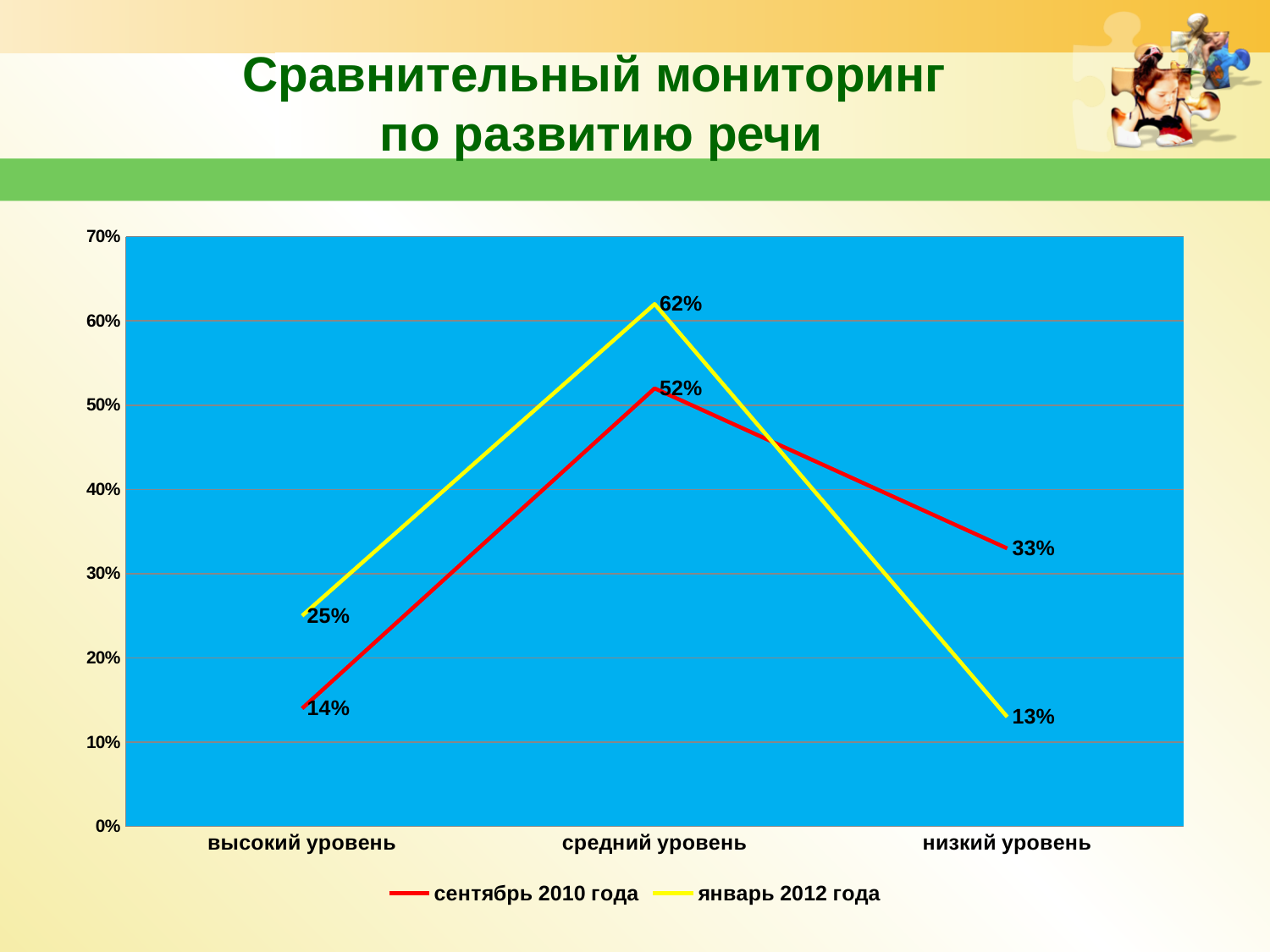
Which series has the larger value for низкий уровень, сентябрь 2010 года or январь 2012 года? сентябрь 2010 года How many categories are shown on the x axis? 3 What is the value for высокий уровень in the январь 2012 года series? 25% What colour is the line for the январь 2012 года series? yellow Which category has the highest value in the январь 2012 года series? средний уровень What is the value for низкий уровень in the сентябрь 2010 года series? 33% Is the value for высокий уровень in the сентябрь 2010 года series greater or less than 20%? less What is the value for средний уровень in the сентябрь 2010 года series? 52% What is the difference between the январь 2012 года and сентябрь 2010 года values for средний уровень? 10% What type of chart is shown on the slide? line chart Which category has the lowest value in the сентябрь 2010 года series? высокий уровень How many series does the legend list? 2